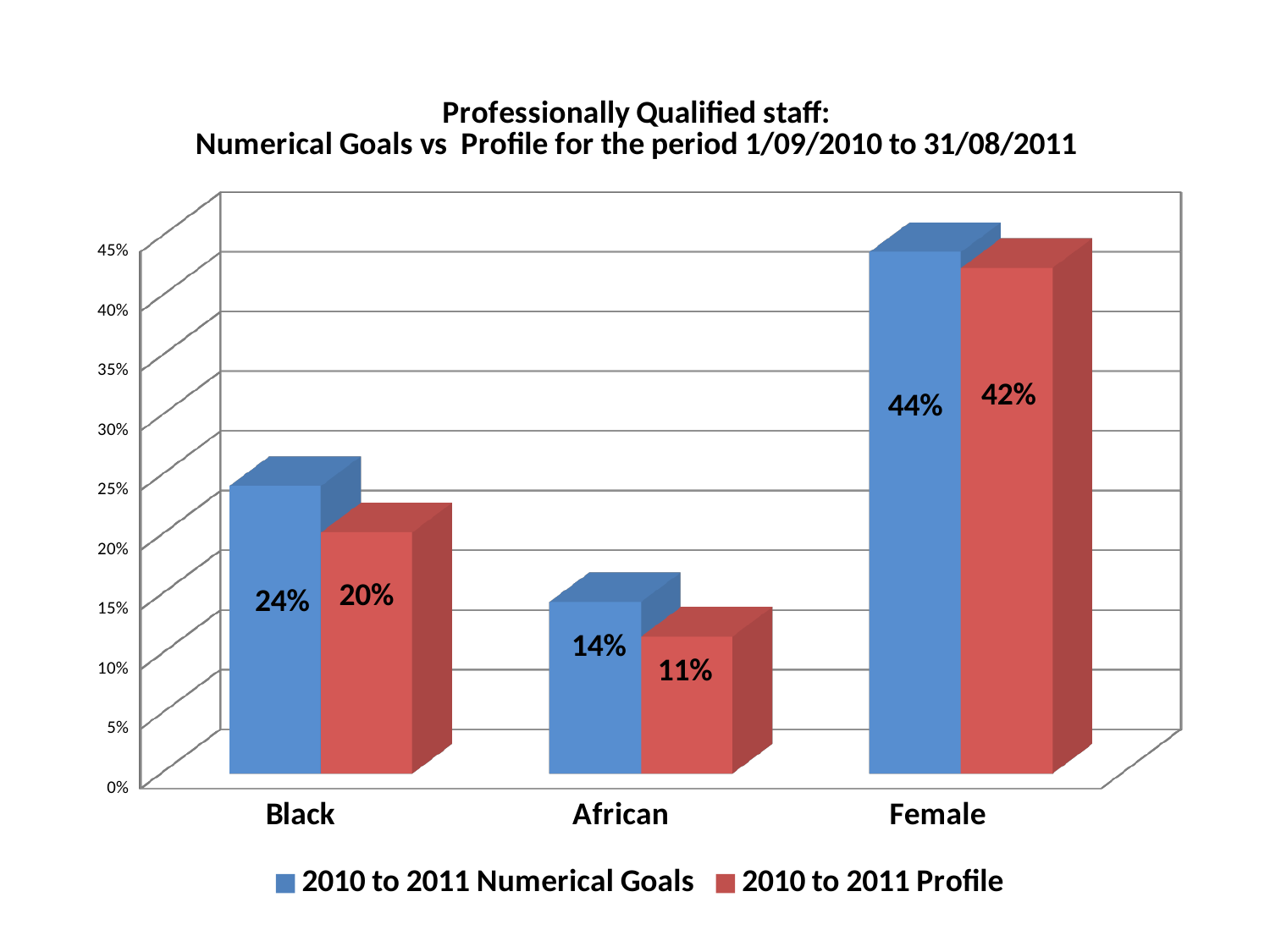
What is the 2010 to 2011 Profile value for Female? 42% How many categories are shown on the x axis? 3 What is the 2010 to 2011 Profile value for African? 11% What is the difference between the Numerical Goals and Profile values for Black? 4% For African, which is larger: the 2010 to 2011 Numerical Goals value or the 2010 to 2011 Profile value? 2010 to 2011 Numerical Goals What is the difference between the Numerical Goals and Profile values for Female? 2% What kind of chart is shown on the slide? Bar chart Which category has the lowest 2010 to 2011 Profile value? African Which category has the highest 2010 to 2011 Numerical Goals value? Female How many series does the legend list? 2 What colour represents the 2010 to 2011 Profile series? Red What is the 2010 to 2011 Numerical Goals value for Black? 24%